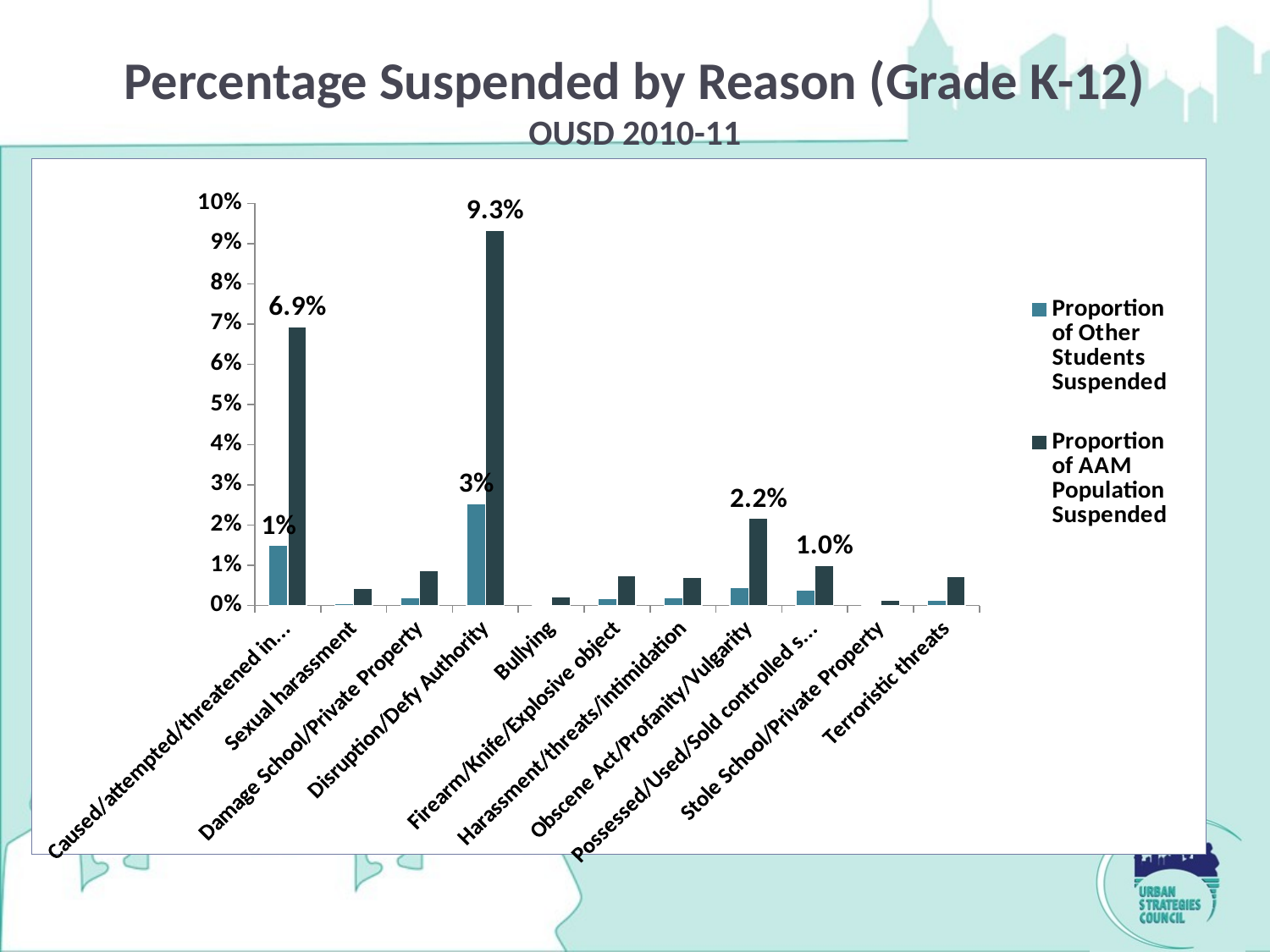
What is the difference between the Proportion of AAM Population Suspended for Disruption/Defy Authority and for Caused/attempted/threatened in...? 2.4% How many series does the legend list? 2 What is the Proportion of AAM Population Suspended for Disruption/Defy Authority? 9.3% What is the Proportion of AAM Population Suspended for Caused/attempted/threatened in...? 6.9% What kind of chart is shown on the slide? Bar chart What is the Proportion of AAM Population Suspended for Possessed/Used/Sold controlled s...? 1.0% What is the Proportion of AAM Population Suspended for Obscene Act/Profanity/Vulgarity? 2.2% Is the Proportion of AAM Population Suspended for Sexual harassment greater or less than 1%? less How many suspension reason categories are shown on the x axis? 11 Which is larger for the Proportion of AAM Population Suspended: Obscene Act/Profanity/Vulgarity or Possessed/Used/Sold controlled s...? Obscene Act/Profanity/Vulgarity Which reason has the highest Proportion of AAM Population Suspended? Disruption/Defy Authority What is the subtitle shown under the chart title? OUSD 2010-11